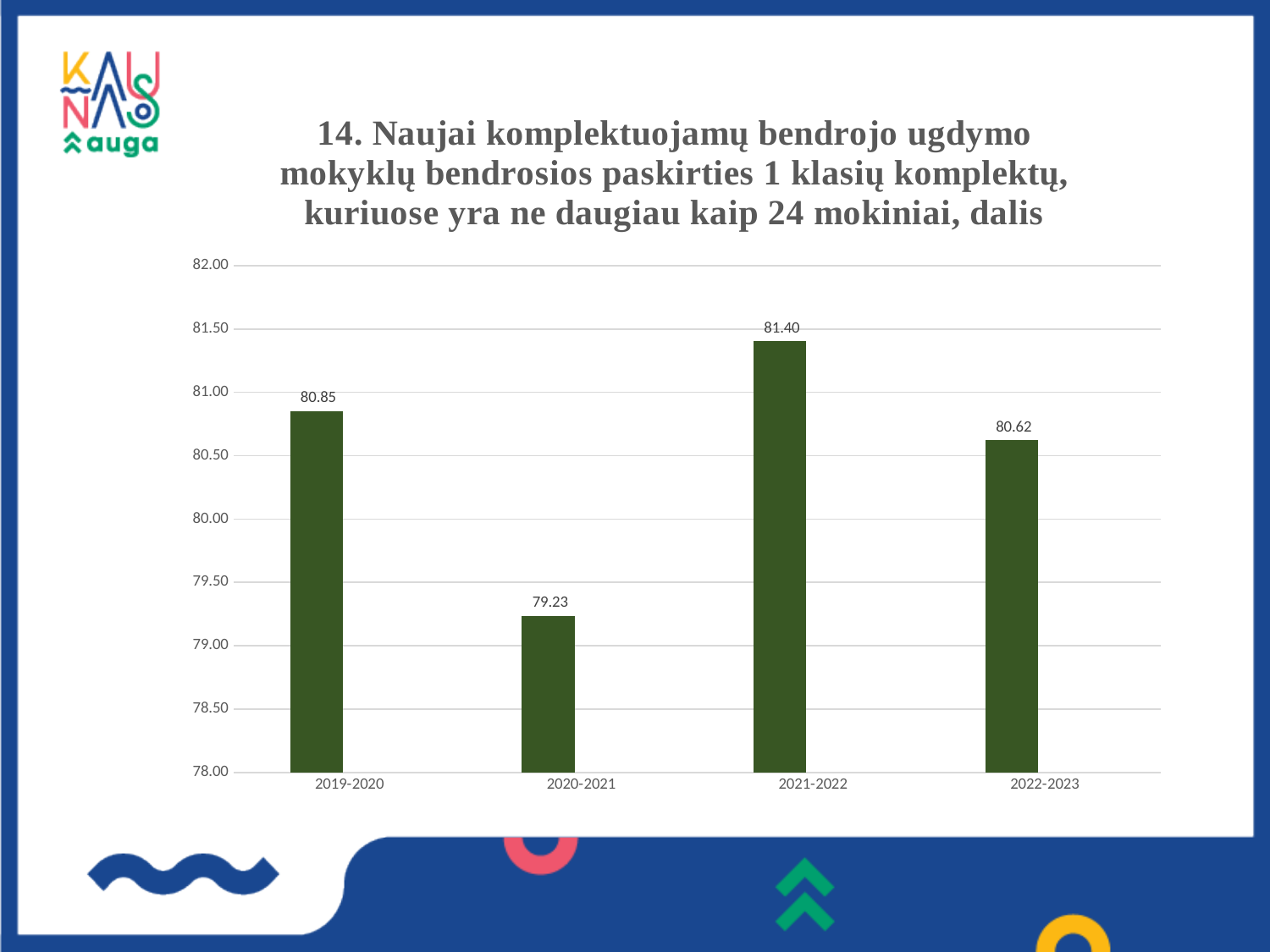
What is the value for 2019-2020? 80.85 Does the value rise or fall from 2021-2022 to 2022-2023? fall Is the value for 2020-2021 greater or less than 79.50? less What is the value for 2020-2021? 79.23 What is the difference between the values for 2021-2022 and 2020-2021? 2.17 How many periods are shown on the x axis? 4 Which is larger, the value for 2019-2020 or the value for 2022-2023? 2019-2020 Which period has the highest value? 2021-2022 What kind of chart is shown on the slide? bar chart What is the value for 2021-2022? 81.40 Which period has the lowest value? 2020-2021 What is the value for 2022-2023? 80.62